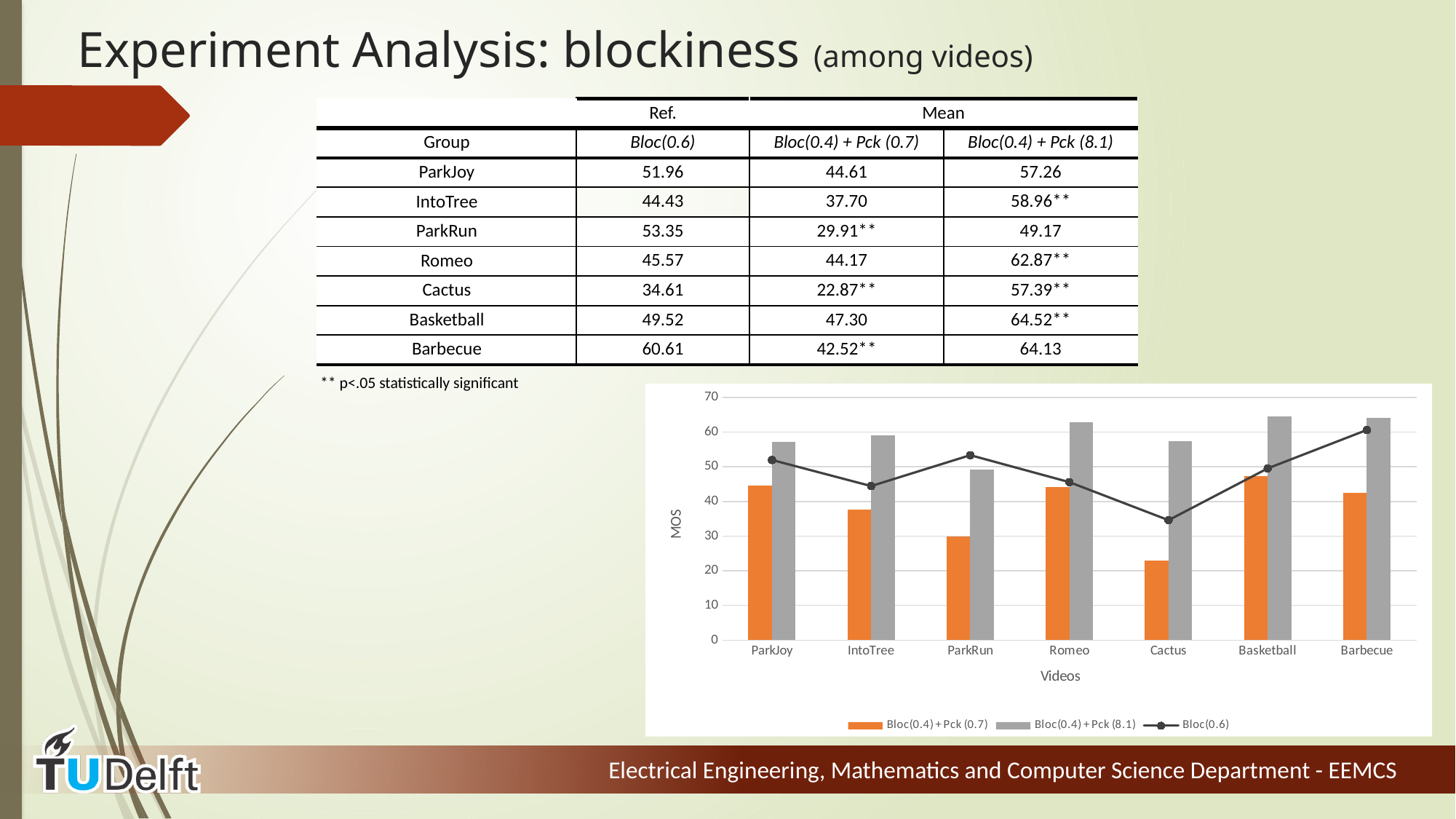
What is the label of the chart's x axis? Videos What is the label of the chart's y axis? MOS Which video has the highest Bloc(0.6) point on the line? Barbecue Is the Bloc(0.4) + Pck (8.1) value for Romeo greater or less than 60? greater How many videos are shown along the x axis of the chart? 7 How many series does the chart legend list? 3 For ParkRun, which is larger: the Bloc(0.6) value or the Bloc(0.4) + Pck (8.1) value? Bloc(0.6) Is the Bloc(0.4) + Pck (0.7) value for Cactus greater or less than 30? less Which video has the lowest Bloc(0.4) + Pck (8.1) bar? ParkRun What kind of chart is shown on the slide? A bar chart combined with a line Which video has the lowest Bloc(0.6) point on the line? Cactus Which video has the lowest Bloc(0.4) + Pck (0.7) bar? Cactus